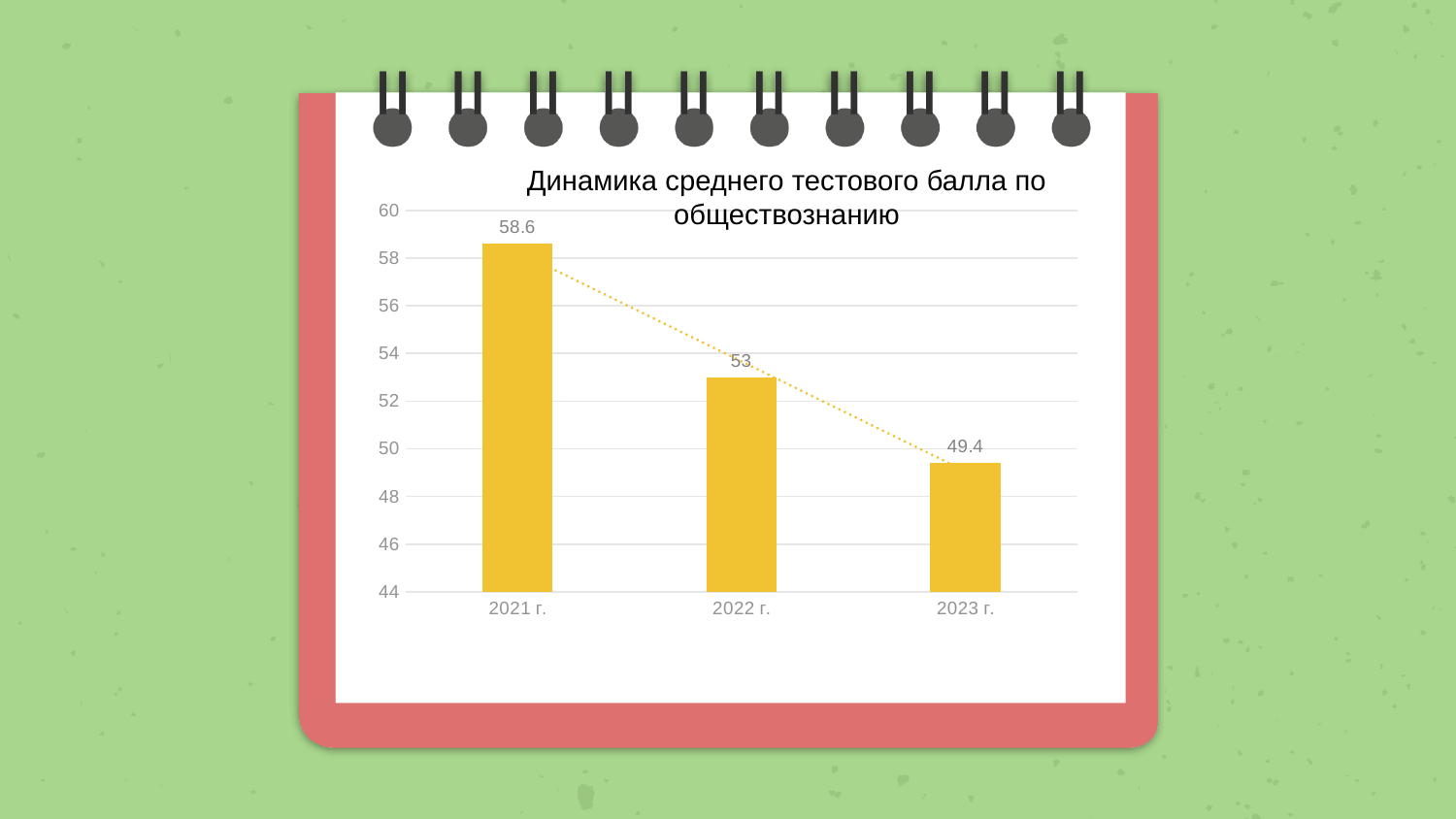
What is the difference between the scores for 2021 г. and 2022 г.? 5.6 What is the average test score for 2023 г.? 49.4 Which year has the lowest average test score? 2023 г. Which is larger, the score for 2022 г. or the score for 2023 г.? 2022 г. Is the value for 2022 г. greater or less than 54? less Which year has the highest average test score? 2021 г. What kind of chart is shown on the slide? bar chart What is the difference between the scores for 2021 г. and 2023 г.? 9.2 How many years are shown on the chart? 3 What is the average test score for 2022 г.? 53 What is the average test score for 2021 г.? 58.6 Do the values rise or fall from 2021 г. to 2023 г.? fall